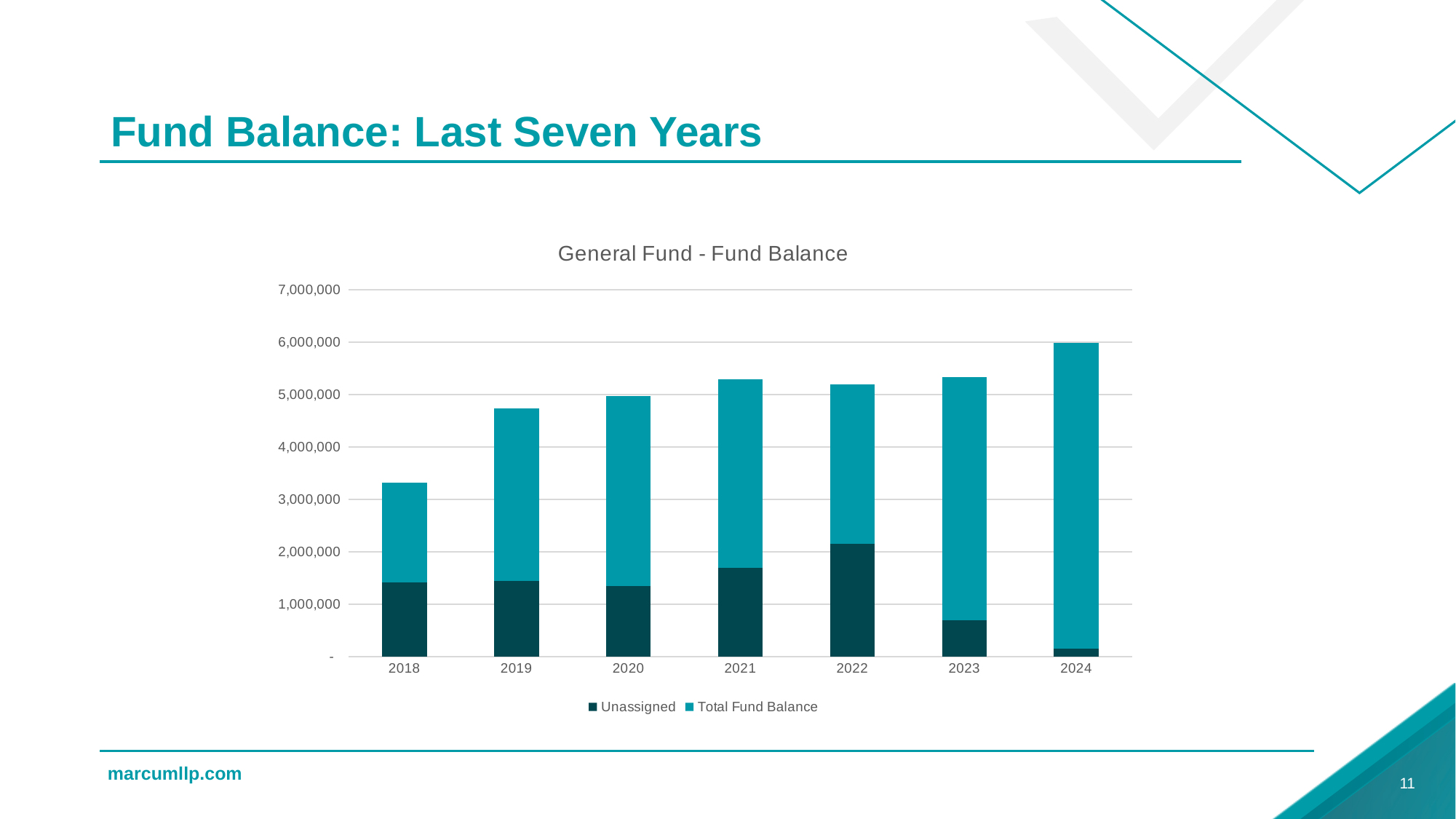
Is the Unassigned value for 2022 greater or less than 2,000,000? greater Which year has the shortest total bar? 2018 Which year has the tallest total bar? 2024 How many series does the chart legend list? 2 What is the title of the chart? General Fund - Fund Balance Which year has the largest Unassigned segment? 2022 Is the total bar height for 2018 greater or less than 3,000,000? greater How many years are shown on the x axis of the chart? 7 Which year has a taller total bar, 2018 or 2019? 2019 What kind of chart is shown on the slide? bar chart Which year has the smallest Unassigned segment? 2024 Is the Unassigned value for 2023 greater or less than 1,000,000? less